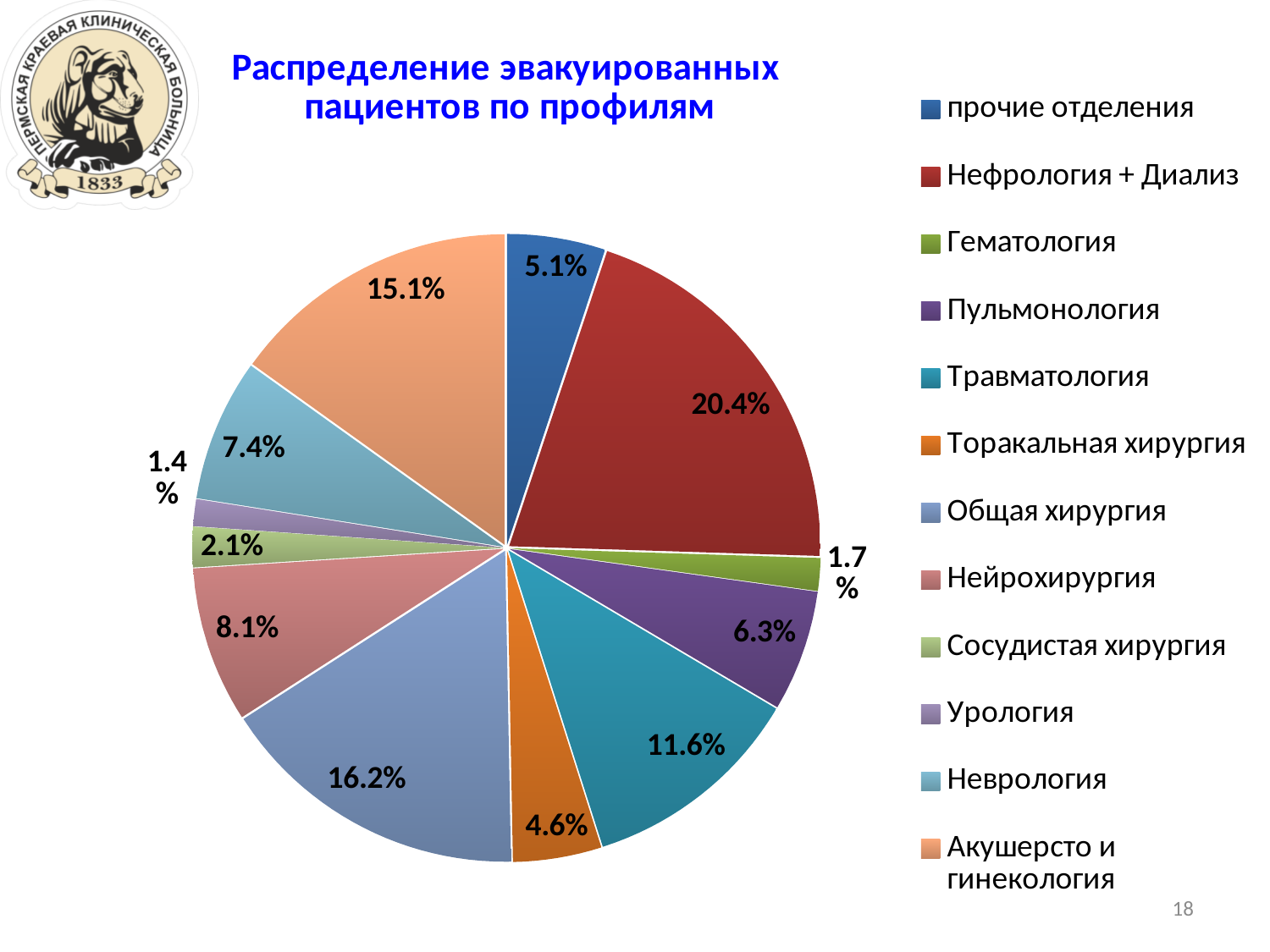
What is the title of the chart? Распределение эвакуированных пациентов по профилям What is the difference between the shares of Травматология and Торакальная хирургия? 7.0% What is the value shown for Общая хирургия? 16.2% What share of evacuated patients does Нефрология + Диализ account for? 20.4% Which profile has the smallest share of evacuated patients? Урология What is the value for Акушерсто и гинекология? 15.1% What percentage is shown for Травматология? 11.6% Which profile has the largest share of evacuated patients? Нефрология + Диализ How many profiles (slices) are shown in the pie chart? 12 Which has a larger share, Неврология or Пульмонология? Неврология What kind of chart is shown on the slide? Pie chart What is the difference between the shares of Общая хирургия and Нейрохирургия? 8.1%